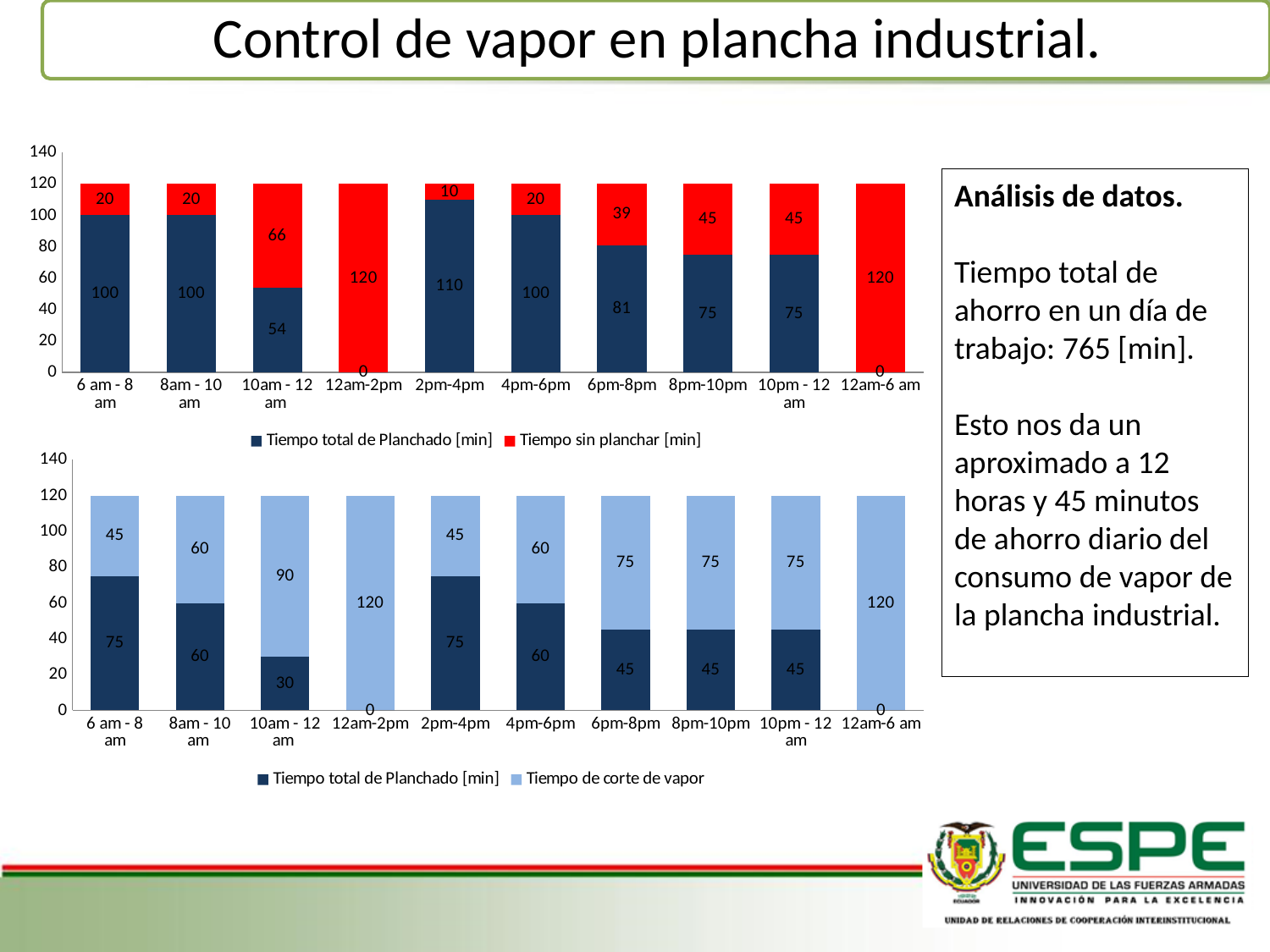
In the top chart, which time slot has the highest Tiempo total de Planchado [min]? 2pm-4pm In the bottom chart, which time slot has the lowest non-zero Tiempo total de Planchado [min]? 10am - 12 am How many series does the legend of the top chart list? 2 In the top chart, what is the value of Tiempo sin planchar [min] for 10am - 12 am? 66 How many time slots are shown on the x axis of the bottom chart? 10 In the top chart, what is the difference between Tiempo total de Planchado [min] for 6pm-8pm and for 8pm-10pm? 6 In the top chart, what is the value of Tiempo total de Planchado [min] for 2pm-4pm? 110 In the bottom chart, what is the value of Tiempo de corte de vapor for 10am - 12 am? 90 In the bottom chart, what is the value of Tiempo total de Planchado [min] for 6pm-8pm? 45 In the top chart, what is the total height of the stacked bar for 6pm-8pm? 120 In the bottom chart, which is larger: Tiempo de corte de vapor for 6 am - 8 am or for 8am - 10 am? 8am - 10 am What type of chart is the bottom chart? Stacked bar chart